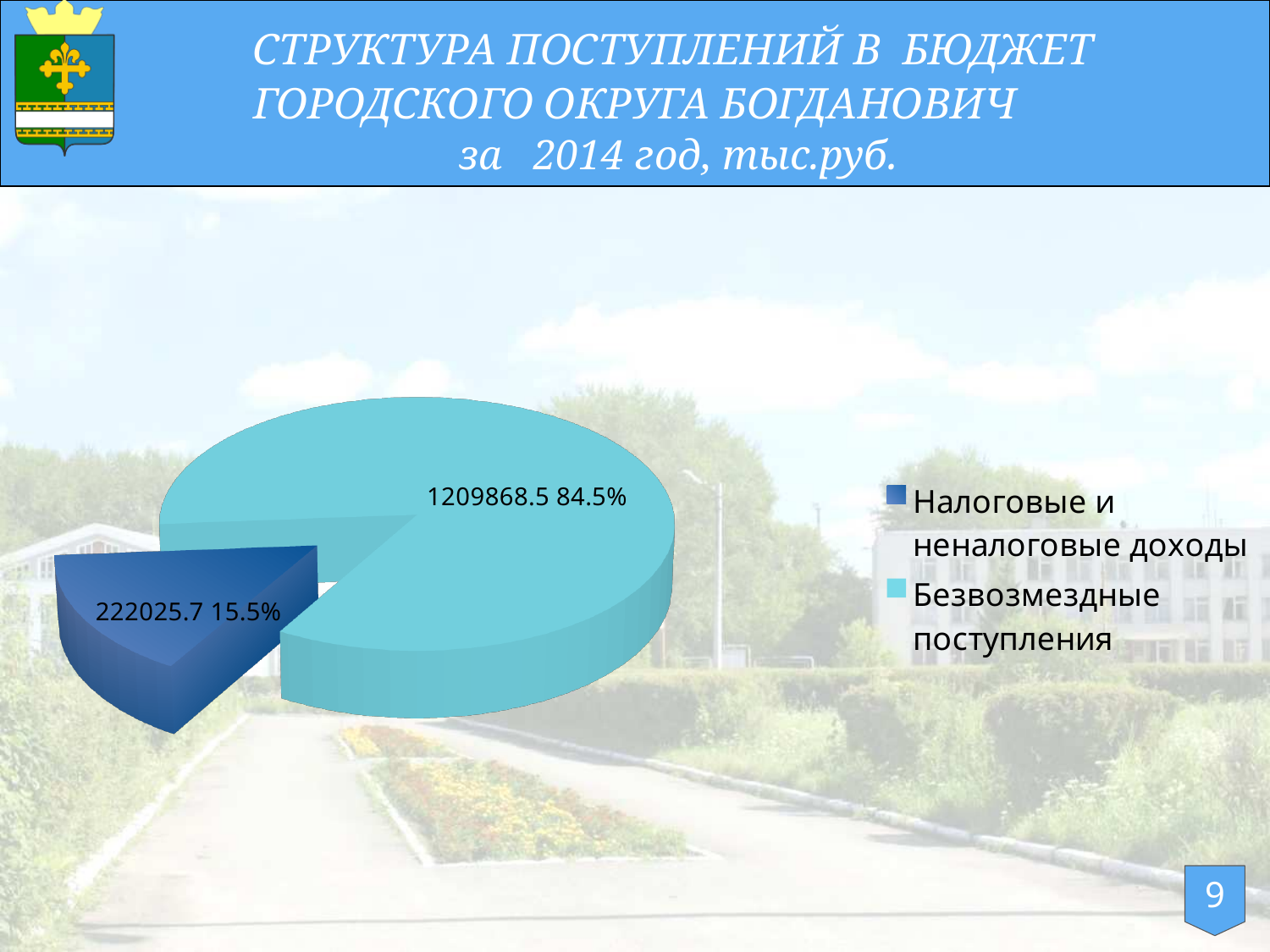
How many entries does the legend list? 2 What is the difference between the values for Безвозмездные поступления and Налоговые и неналоговые доходы? 987842.8 What share of the pie does Налоговые и неналоговые доходы take? 15.5% What colour is the slice for Налоговые и неналоговые доходы? dark blue Which category has the smallest slice of the pie? Налоговые и неналоговые доходы What share of the pie does Безвозмездные поступления take? 84.5% What is the value for Налоговые и неналоговые доходы? 222025.7 What kind of chart is shown on the slide? pie chart Which category has the largest slice of the pie? Безвозмездные поступления Which is larger, Безвозмездные поступления or Налоговые и неналоговые доходы? Безвозмездные поступления How many slices does the pie chart have? 2 What is the value for Безвозмездные поступления? 1209868.5